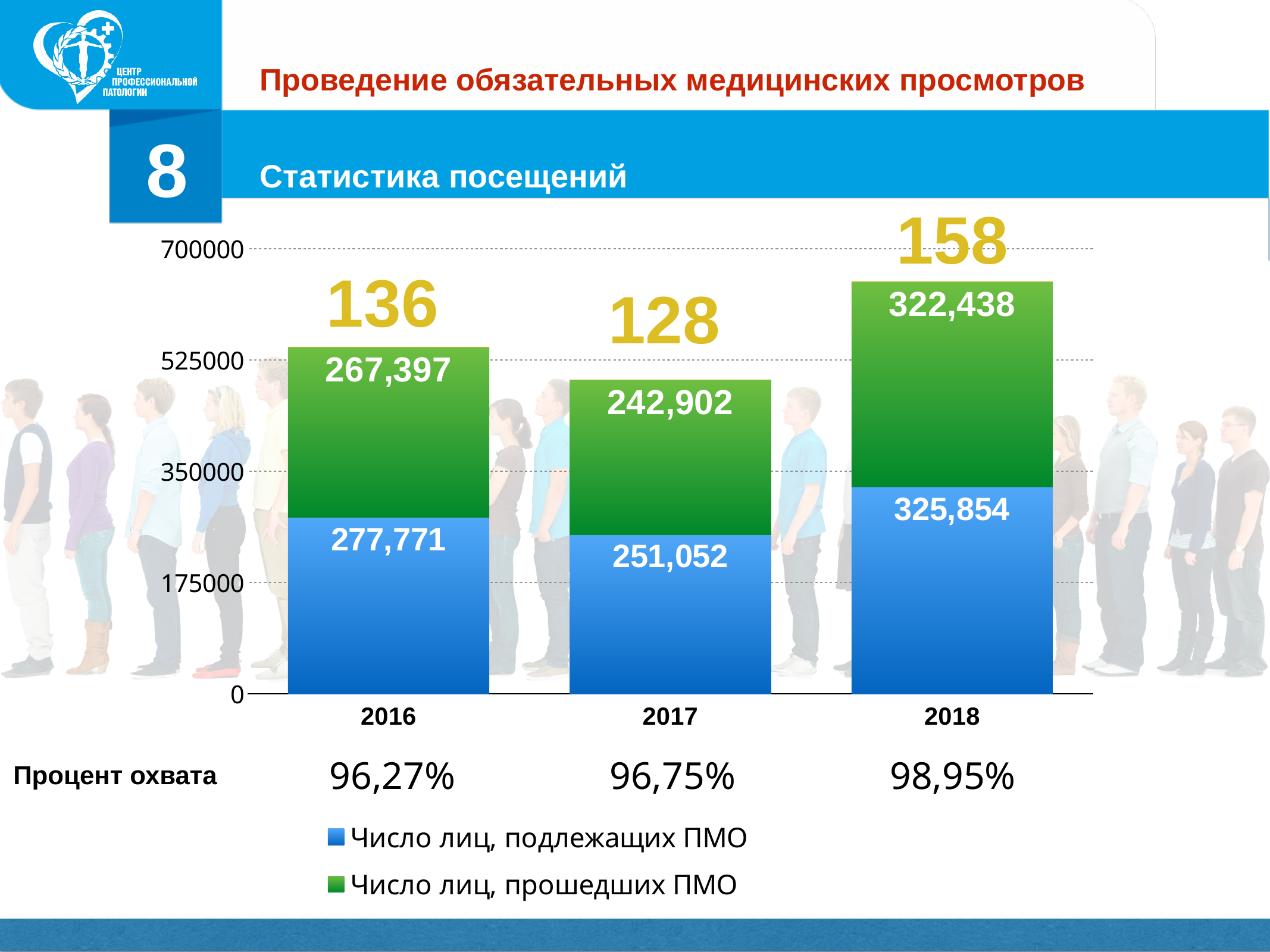
What is the total of the stacked bar for 2018? 648,292 What type of chart is shown on the slide? Stacked bar chart How many years are shown on the x axis of the chart? 3 What is the value of "Число лиц, прошедших ПМО" for 2018? 322,438 What is the value of "Число лиц, прошедших ПМО" for 2017? 242,902 What is the difference between the "Число лиц, подлежащих ПМО" values for 2018 and 2016? 48,083 What is the value of "Число лиц, подлежащих ПМО" for 2016? 277,771 Which year has the lowest value for "Число лиц, прошедших ПМО"? 2017 Which is larger: "Число лиц, прошедших ПМО" in 2016 or in 2017? 2016 Which year has the highest value for "Число лиц, подлежащих ПМО"? 2018 How many series does the chart legend list? 2 What is the total of the stacked bar for 2017? 493,954